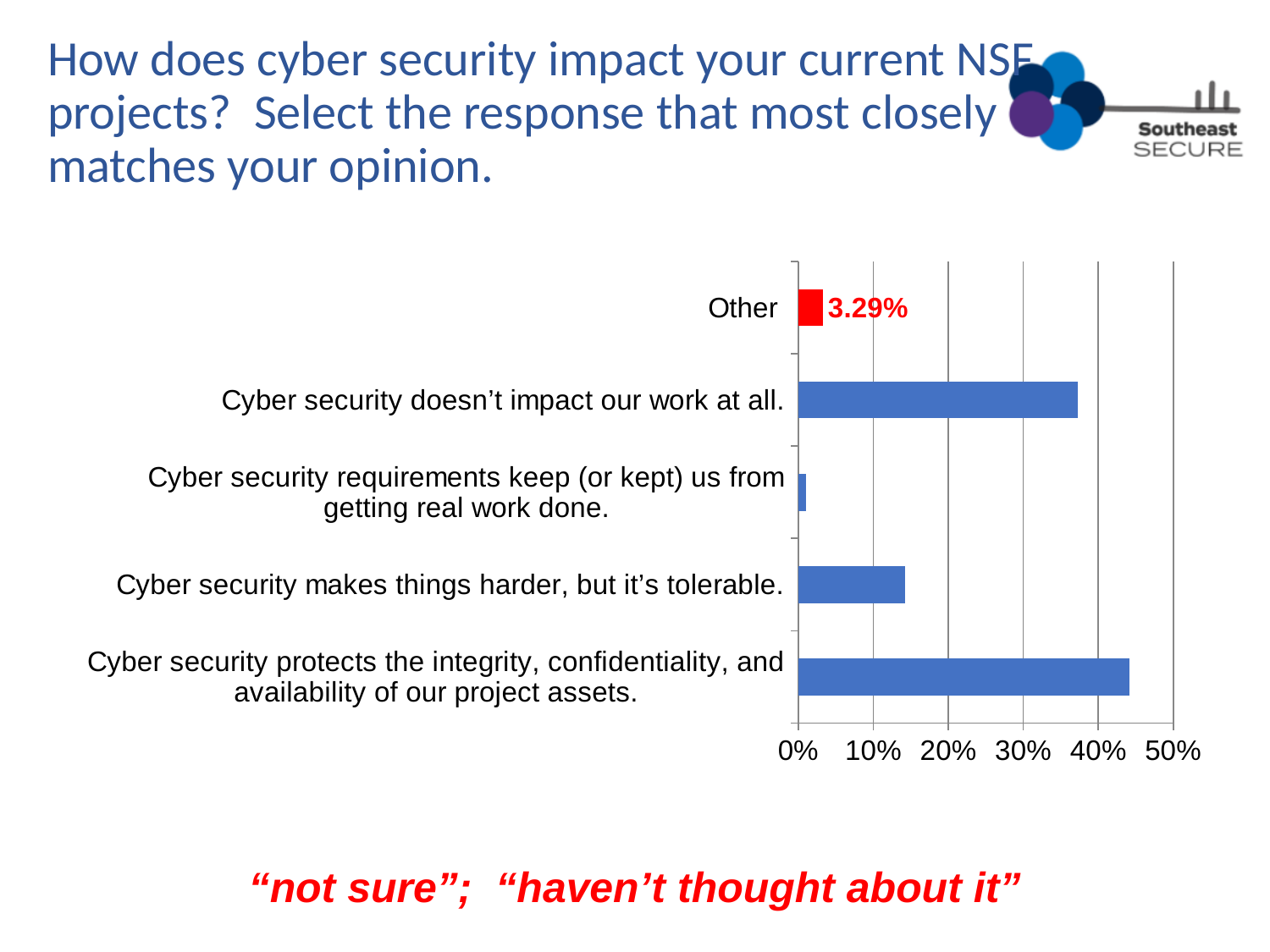
What is the value shown for the "Other" category? 3.29% Is the value for "Cyber security doesn't impact our work at all." greater or less than 30%? greater Which response has the lowest value? Cyber security requirements keep (or kept) us from getting real work done. Is the value for "Cyber security protects the integrity, confidentiality, and availability of our project assets." greater or less than 40%? greater Is the value for "Cyber security requirements keep (or kept) us from getting real work done." greater or less than 10%? less What colour is the bar for the "Other" category? red What kind of chart is shown on the slide? bar chart Which is larger: the value for "Cyber security doesn't impact our work at all." or the value for "Cyber security makes things harder, but it's tolerable."? Cyber security doesn't impact our work at all. How many response categories are shown in the chart? 5 Which is larger: the value for "Cyber security protects the integrity, confidentiality, and availability of our project assets." or the value for "Cyber security doesn't impact our work at all."? Cyber security protects the integrity, confidentiality, and availability of our project assets. Which response has the highest value? Cyber security protects the integrity, confidentiality, and availability of our project assets.